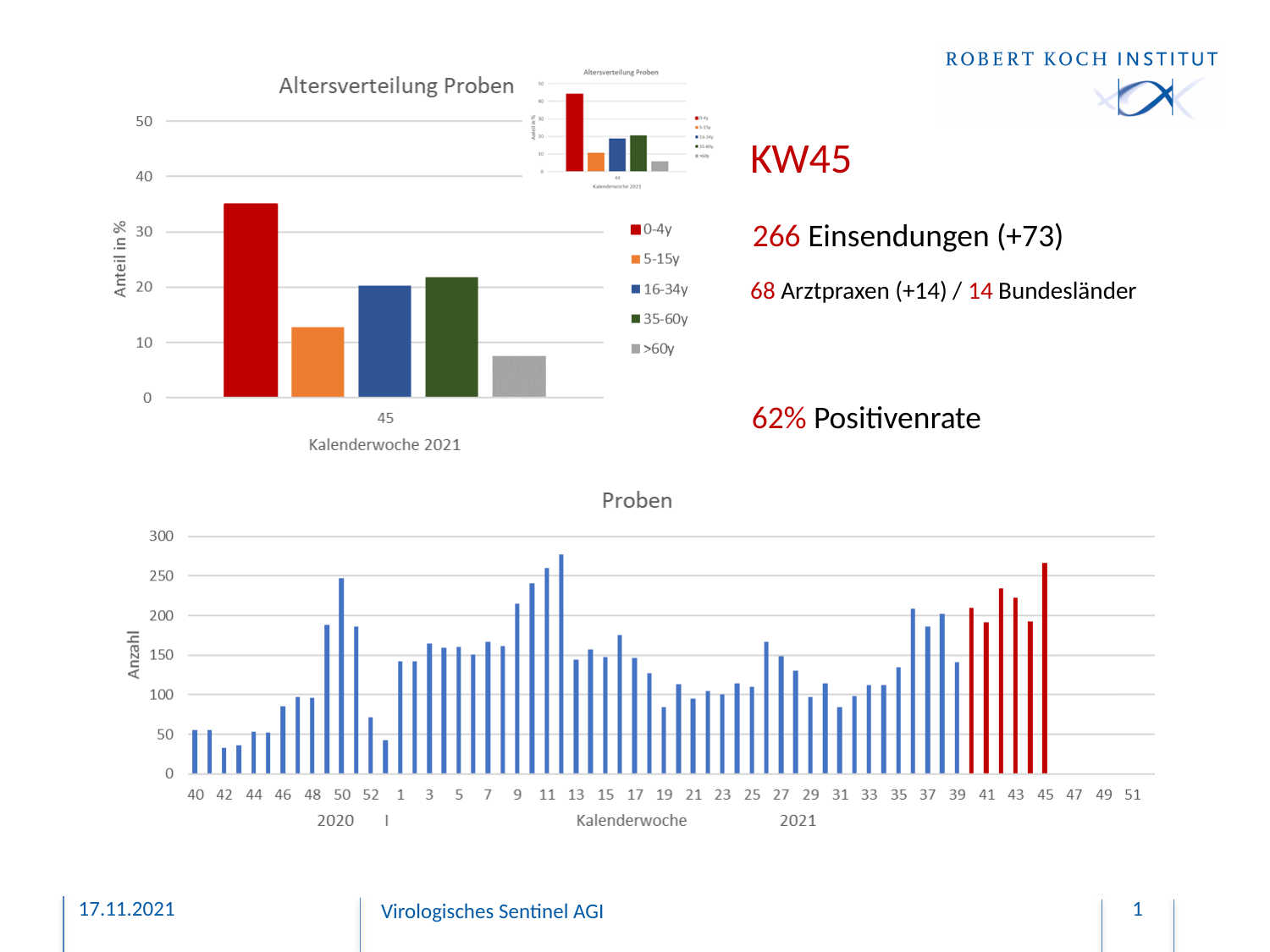
In the 'Altersverteilung Proben' chart at the top left, which age group has the highest share? 0-4y In the 'Altersverteilung Proben' chart at the top left, which is larger, the value for 0-4y or the value for 5-15y? 0-4y In the 'Proben' chart at the bottom, do the values generally rise or fall from week 40 to week 50 of 2020? rise What kind of chart is the 'Altersverteilung Proben' chart at the top left? bar chart In the 'Altersverteilung Proben' chart at the top left, is the value for >60y greater or less than 10? less In the 'Altersverteilung Proben' chart at the top left, is the value for 0-4y greater or less than 30? greater Which calendar week is shown on the x axis of the 'Altersverteilung Proben' chart at the top left? 45 How many series does the legend of the 'Altersverteilung Proben' chart at the top left list? 5 What is the y-axis label of the 'Proben' chart at the bottom? Anzahl In the 'Proben' chart at the bottom, is the value for week 40 of 2020 greater or less than 100? less In the 'Altersverteilung Proben' chart at the top left, which age group has the lowest share? >60y